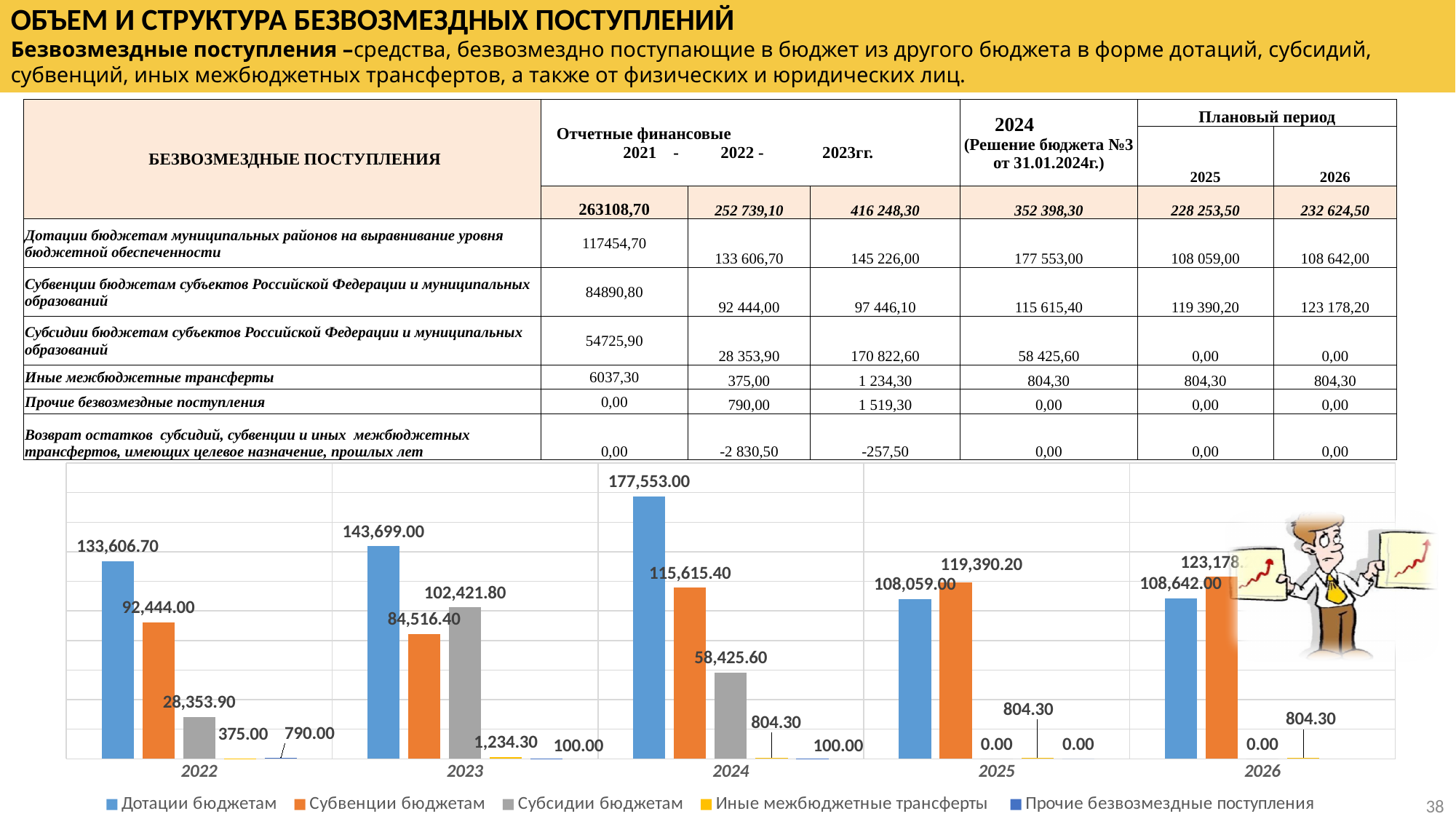
In which year is the Дотации бюджетам bar highest in the chart? 2024 What is the value of Субвенции бюджетам for 2025 in the chart? 119,390.20 What is the value of Дотации бюджетам for 2024 in the chart? 177,553.00 In the chart, which is larger for 2025: Дотации бюджетам or Субвенции бюджетам? Субвенции бюджетам In which year is the Субвенции бюджетам bar lowest in the chart? 2023 How many series does the chart legend list? 5 How many year categories are shown on the x axis of the chart? 5 Which colour represents Субсидии бюджетам in the chart legend? gray What is the difference between Дотации бюджетам and Субвенции бюджетам for 2024 in the chart? 61,937.60 What is the value of Иные межбюджетные трансферты for 2022 in the chart? 375.00 What is the value of Субсидии бюджетам for 2023 in the chart? 102,421.80 What type of chart is shown at the bottom of the slide? bar chart